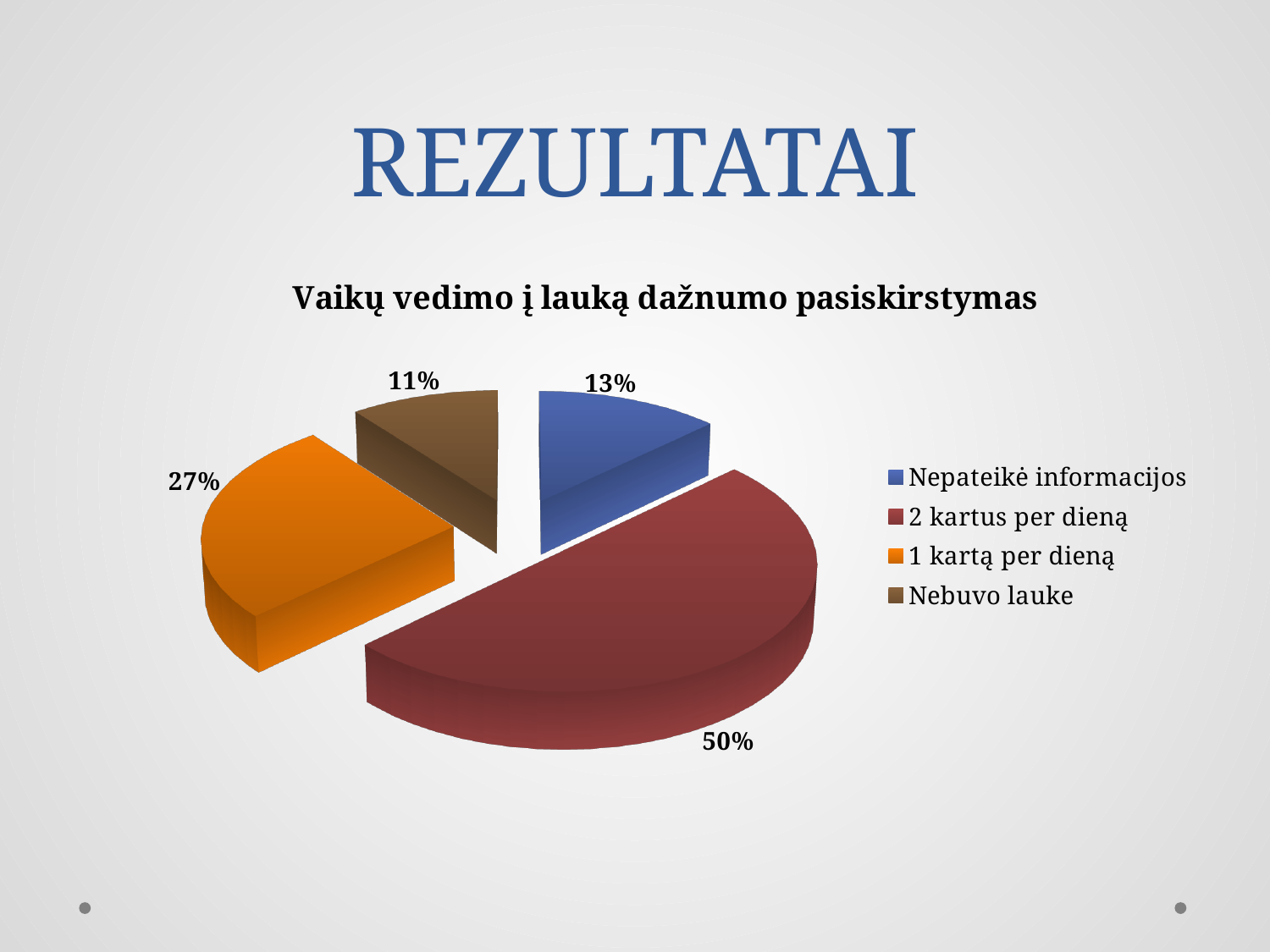
Which is larger, the share for "Nepateikė informacijos" or the share for "Nebuvo lauke"? Nepateikė informacijos What is the value shown for "Nebuvo lauke"? 11% What is the value shown for "1 kartą per dieną"? 27% How many categories are shown in the pie chart? 4 Which category has the smallest slice of the pie? Nebuvo lauke What is the value shown for "Nepateikė informacijos"? 13% Which category has the largest slice of the pie? 2 kartus per dieną What share of the pie does "2 kartus per dieną" take? 50% What is the title of the chart? Vaikų vedimo į lauką dažnumo pasiskirstymas Which colour represents "1 kartą per dieną" in the chart? Orange What kind of chart is shown on the slide? Pie chart What is the difference between the shares for "2 kartus per dieną" and "1 kartą per dieną"? 23%